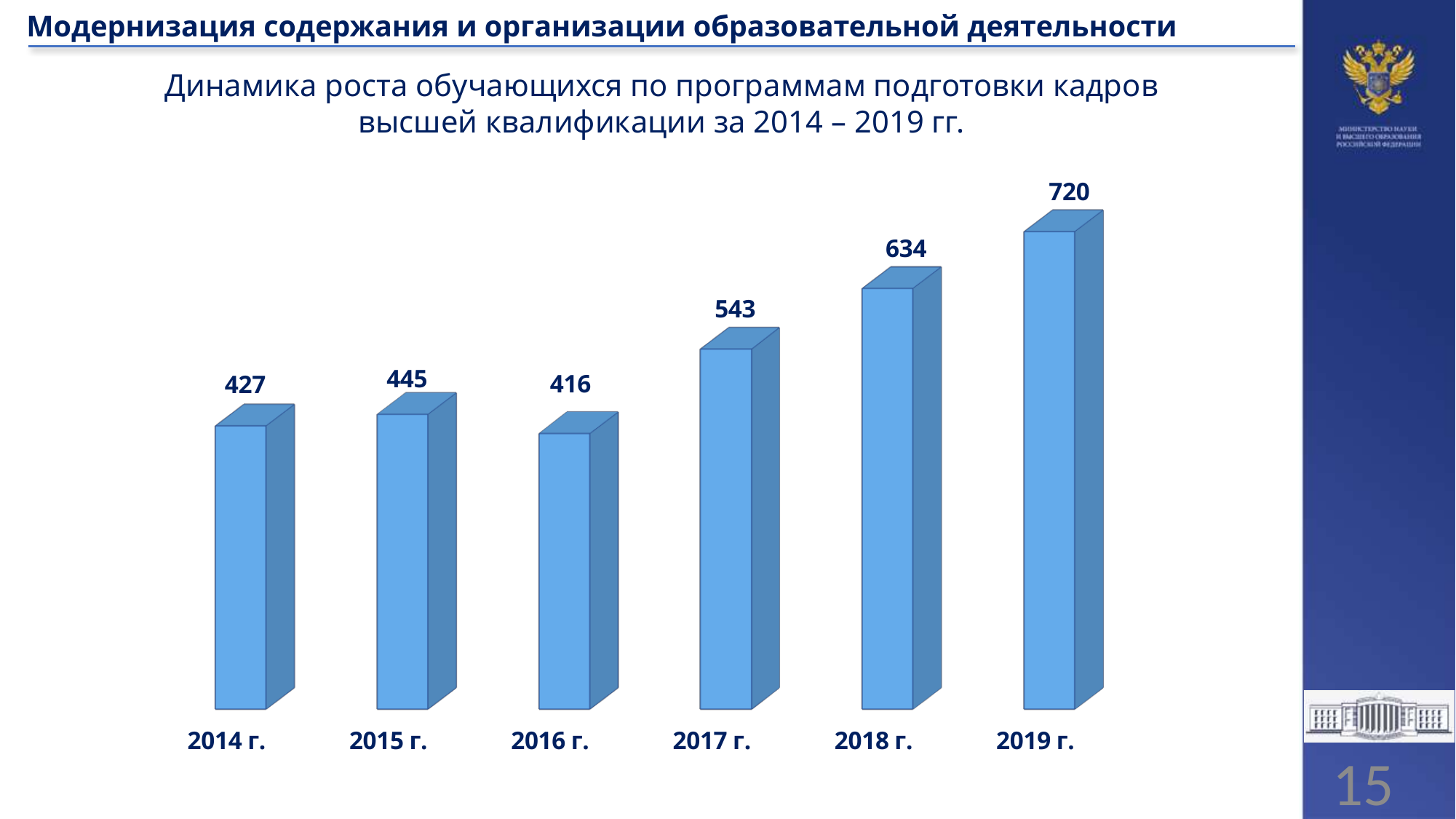
Which year has the highest value? 2019 г. What is the value for 2014 г.? 427 Which year has the lowest value? 2016 г. What is the value for 2019 г.? 720 How many years are shown on the chart? 6 What kind of chart is shown on the slide? bar chart Do the values generally rise or fall from 2016 г. to 2019 г.? rise What is the difference between the values for 2019 г. and 2018 г.? 86 What is the difference between the values for 2017 г. and 2016 г.? 127 Which is larger, the value for 2015 г. or the value for 2016 г.? 2015 г. What is the title of the chart? Динамика роста обучающихся по программам подготовки кадров высшей квалификации за 2014 – 2019 гг. What is the value for 2017 г.? 543